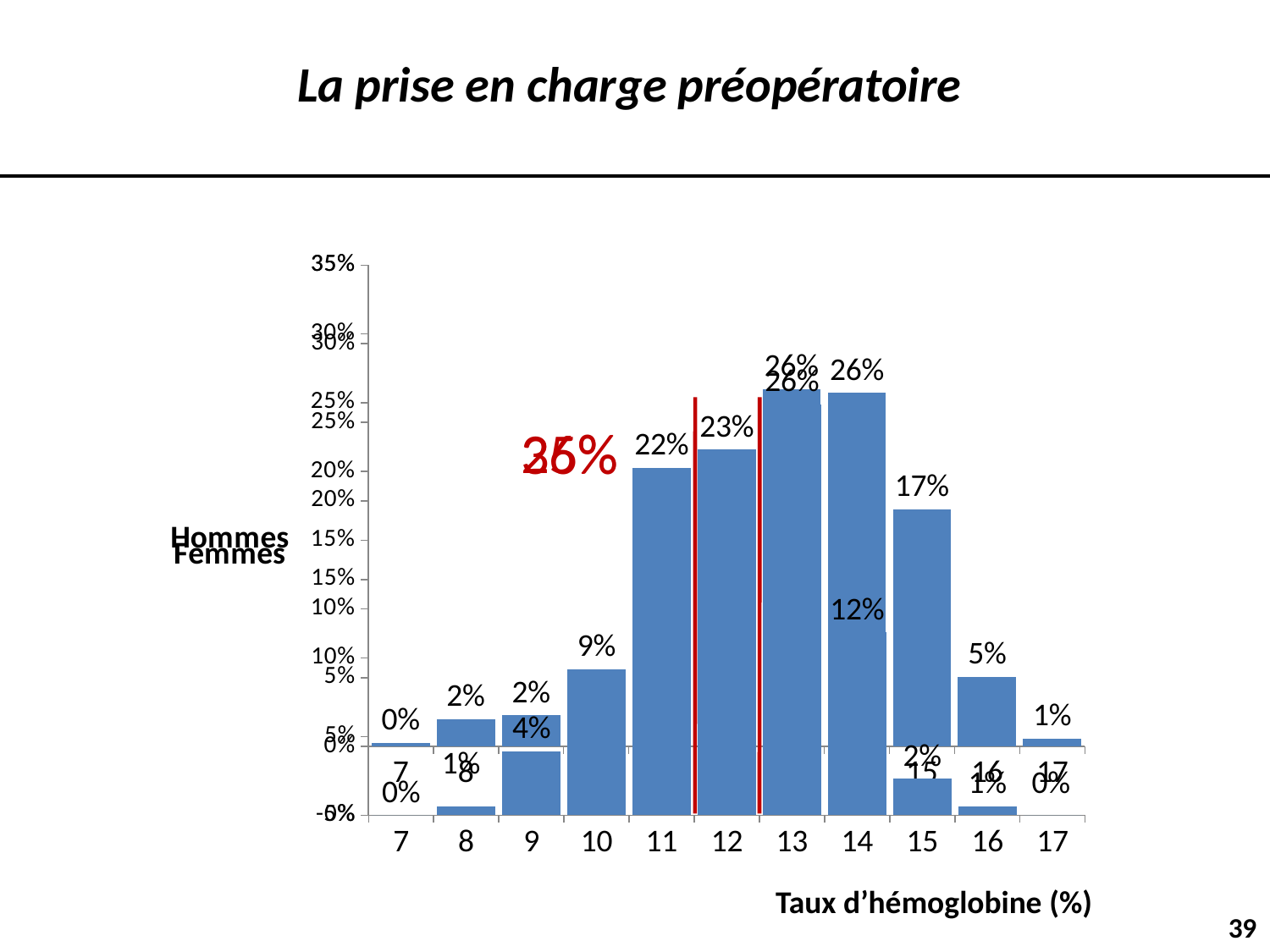
How many hemoglobin-rate categories are shown along the x axis of the chart? 11 What kind of chart is shown on the slide? bar chart What is the x-axis title of the chart on the slide? Taux d'hémoglobine (%) In the taller chart (the one whose bars reach 26%), which is larger: the value for hemoglobin rate 15 or for hemoglobin rate 16? 15 In the taller chart (the one whose bars reach 26%), do the values rise or fall from hemoglobin rate 7 to 13? rise